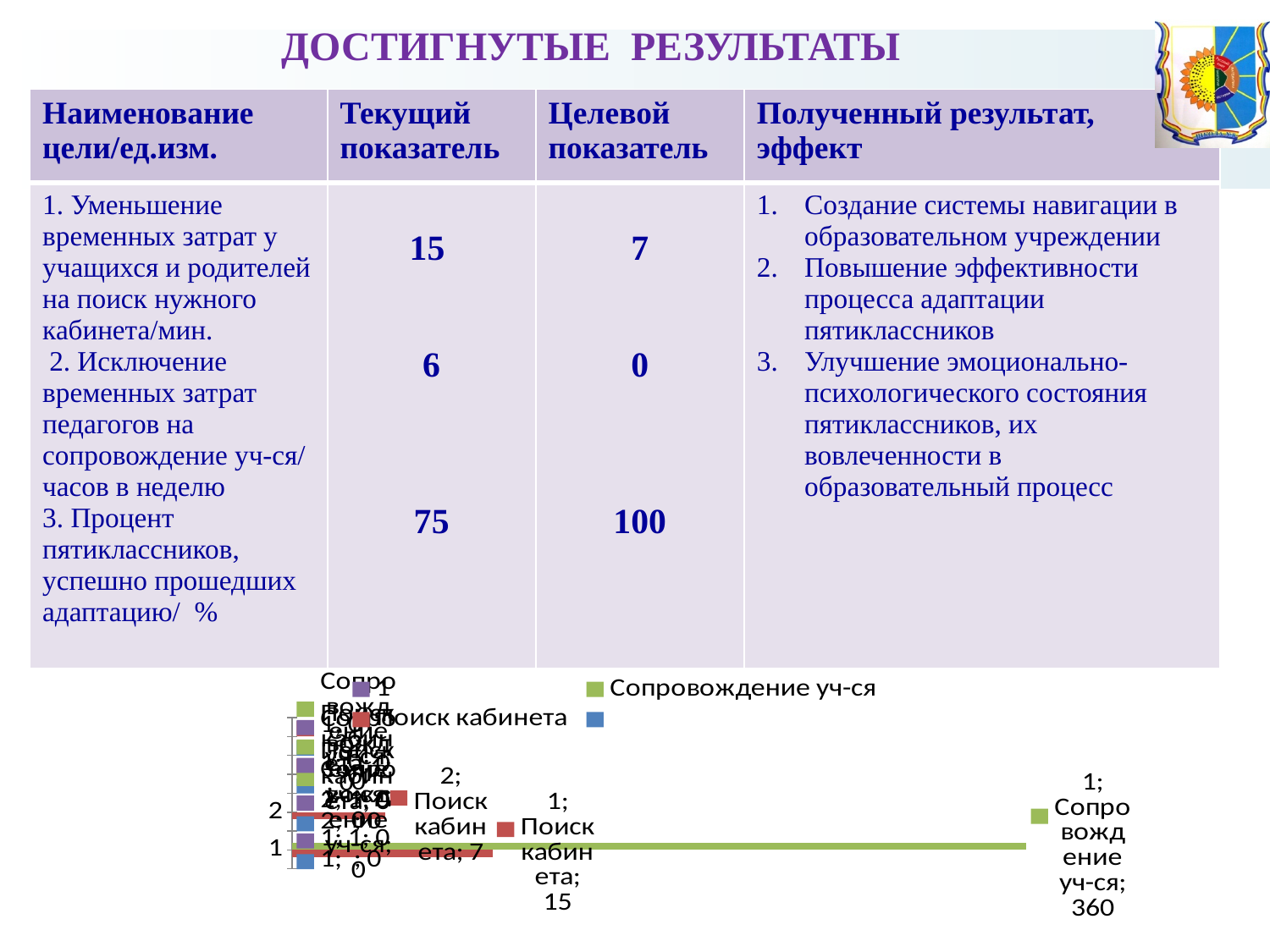
In the chart, which is larger for category 1: the Сопровождение уч-ся value or the Поиск кабинета value? Сопровождение уч-ся Which legend entry in the chart is shown in red? Поиск кабинета What kind of chart is shown at the bottom of the slide? bar chart In the chart, what is the value labelled for Поиск кабинета in category 1? 15 In the chart, what is the value labelled for Поиск кабинета in category 2? 7 How many categories are shown on the vertical axis of the chart? 2 In the chart, what is the difference between the Поиск кабинета values for category 1 and category 2? 8 Which legend entry in the chart is shown in green? Сопровождение уч-ся In the chart, which labelled bar has the highest value? Сопровождение уч-ся (360) In the chart, what is the value labelled for Сопровождение уч-ся in category 1? 360